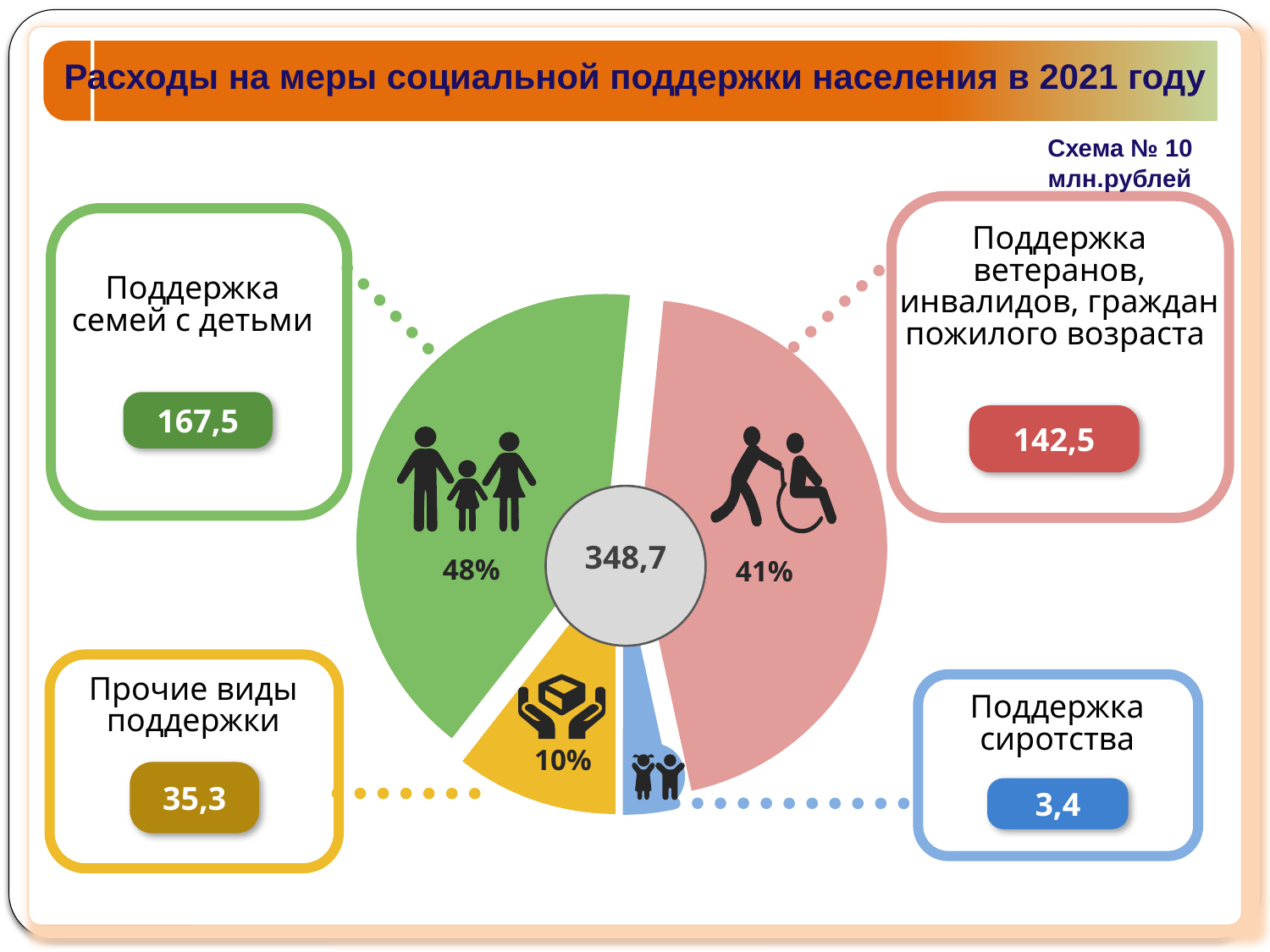
What is the value for «Поддержка сиротства»? 3,4 Which category has the largest value? Поддержка семей с детьми What is the difference between the values for «Поддержка семей с детьми» and «Поддержка ветеранов, инвалидов, граждан пожилого возраста»? 25 What total value is shown in the centre of the pie chart? 348,7 How many slices does the pie chart have? 4 What share of the pie does «Прочие виды поддержки» take? 10% What is the value for «Прочие виды поддержки»? 35,3 What share of the pie does «Поддержка семей с детьми» take? 48% What is the value for «Поддержка семей с детьми»? 167,5 What is the value for «Поддержка ветеранов, инвалидов, граждан пожилого возраста»? 142,5 Which category has the smallest value? Поддержка сиротства What kind of chart is shown on the slide? pie chart